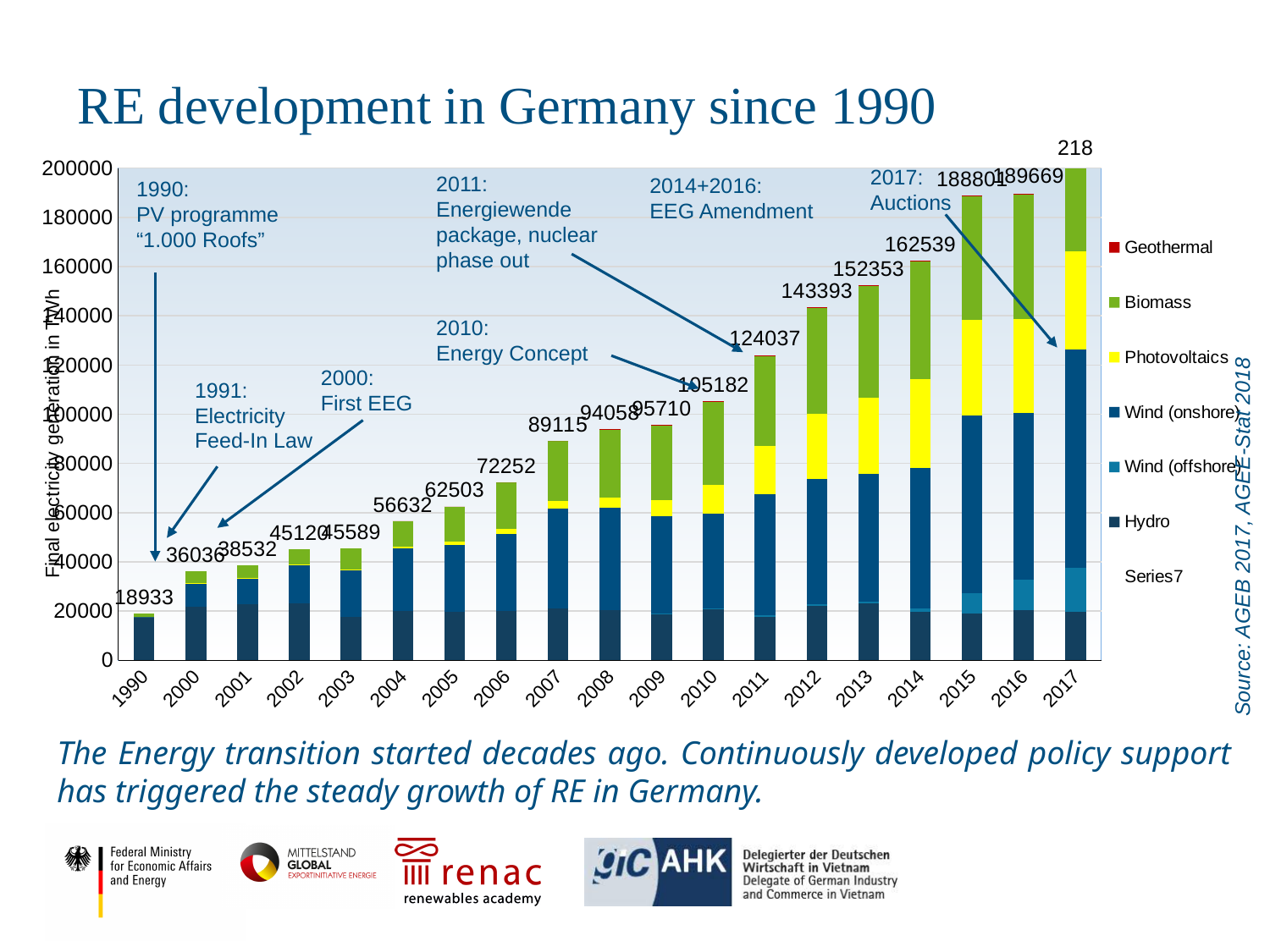
Is the total for 2012 greater or less than 140000? greater How many entries does the legend list? 7 How many years (bars) are shown on the x axis? 19 Which year has the highest total bar? 2017 What is the total labelled on the bar for 1990? 18933 What is the difference between the labelled totals for 2016 and 2015? 868 Do the total values rise or fall from 1990 to 2017? Rise What is the total labelled on the bar for 2014? 162539 Which is larger, the labelled total for 2008 or for 2009? 2009 What is the total labelled on the bar for 2010? 105182 What kind of chart is shown on the slide? Stacked bar chart Which year has the lowest total bar? 1990